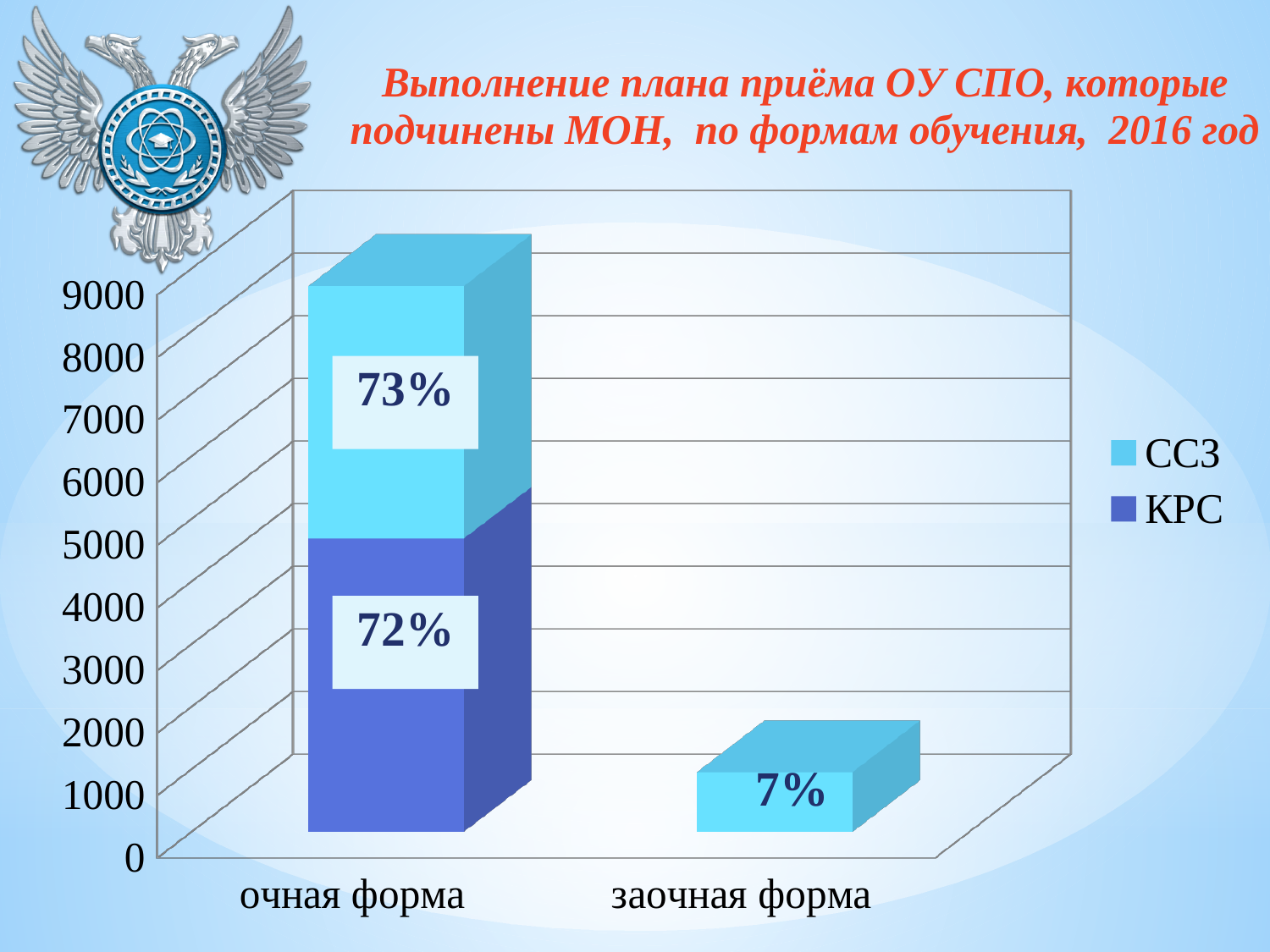
What percentage label is shown on the ССЗ segment for "очная форма"? 73% Which series is shown in light blue in the chart legend? ССЗ How many series does the chart legend list? 2 How many categories are shown on the x axis of the chart? 2 What percentage label is shown on the КРС segment for "очная форма"? 72% Which category has the lowest bar in the chart? заочная форма Which category has the taller stacked bar, "очная форма" or "заочная форма"? очная форма What percentage label is shown on the bar for "заочная форма"? 7% Is the value of the bar for "заочная форма" greater or less than 2000? less What are the two series listed in the chart legend? ССЗ and КРС What kind of chart is shown on the slide? bar chart Is the total height of the stacked bar for "очная форма" greater or less than 5000? greater